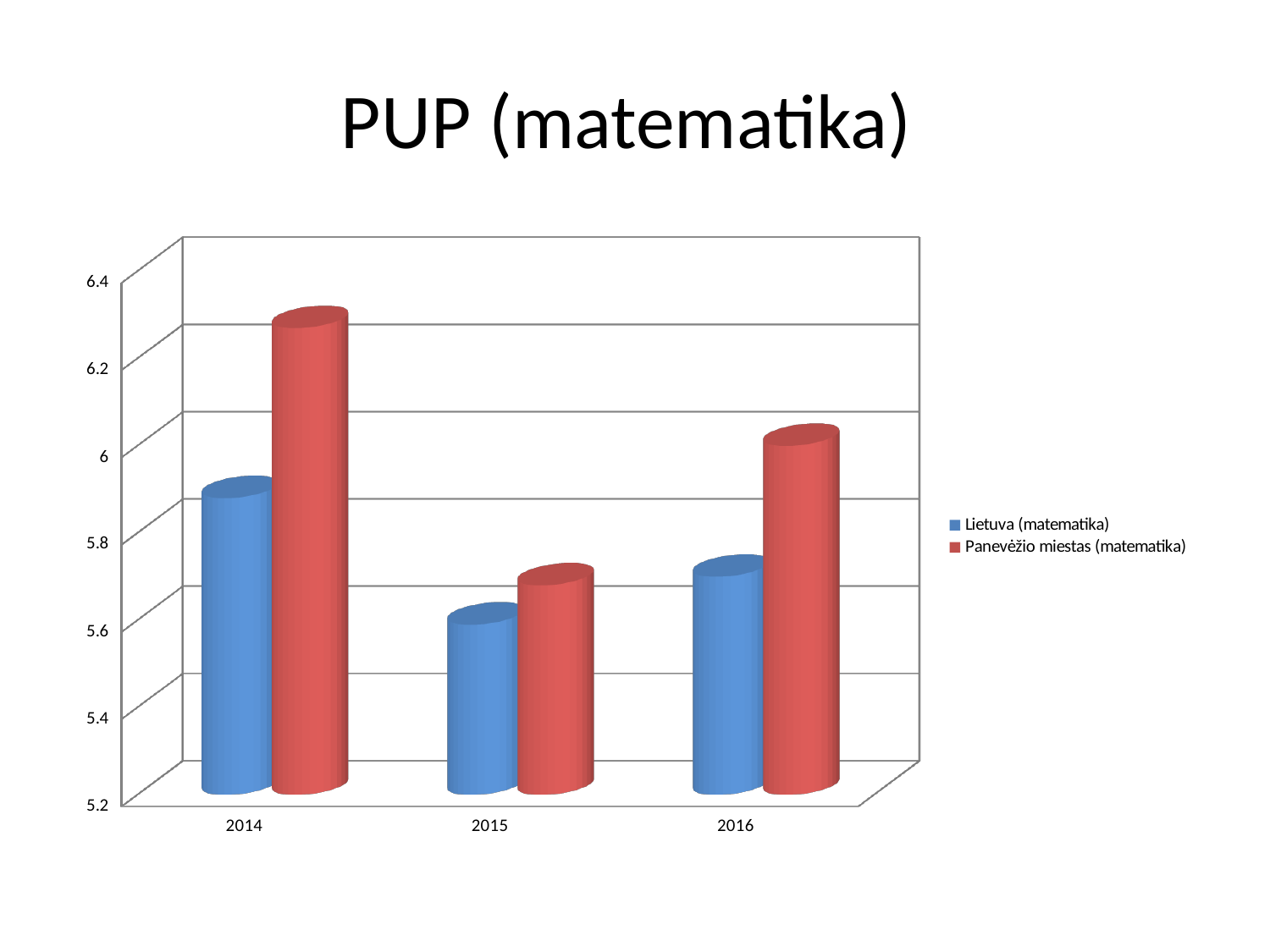
Which bar is the lowest in the chart? Lietuva (matematika) in 2015 Does the value for Lietuva (matematika) rise or fall from 2014 to 2015? fall Which bar is the highest in the chart? Panevėžio miestas (matematika) in 2014 What kind of chart is shown on the slide? bar chart How many years are shown on the x axis? 3 Is the value for Panevėžio miestas (matematika) in 2016 greater or less than 5.8? greater Which series is shown in red? Panevėžio miestas (matematika) What is the title of the chart? PUP (matematika) Is the value for Panevėžio miestas (matematika) in 2014 greater or less than 6.2? greater In 2014, which is larger: Lietuva (matematika) or Panevėžio miestas (matematika)? Panevėžio miestas (matematika) How many series does the legend list? 2 Is the value for Lietuva (matematika) in 2015 greater or less than 5.8? less